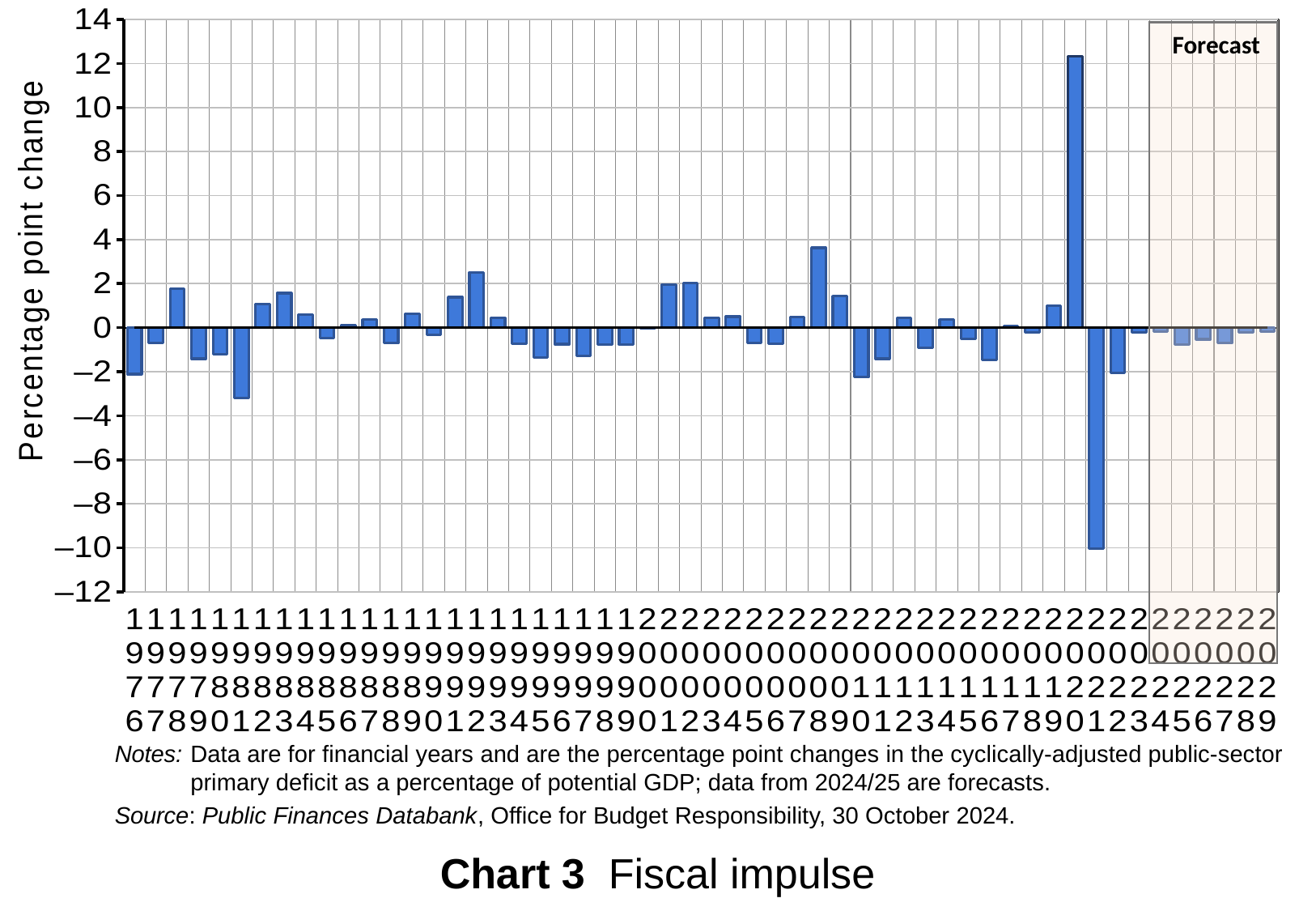
Is the value for 2008 greater or less than 2? greater Which year has the highest percentage point change in Chart 3? 2020 Is the value for 2021 greater or less than -8? less What kind of chart is Chart 3 Fiscal impulse? bar chart What is the label on the vertical axis of the chart? Percentage point change Which year has the lowest percentage point change in Chart 3? 2021 How many years are plotted in Chart 3? 54 Is the value for 1981 greater or less than -2? less Which year has the lower value, 1976 or 1981? 1981 How many years fall within the shaded Forecast region of the chart? 6 Which year has the larger value, 2008 or 2020? 2020